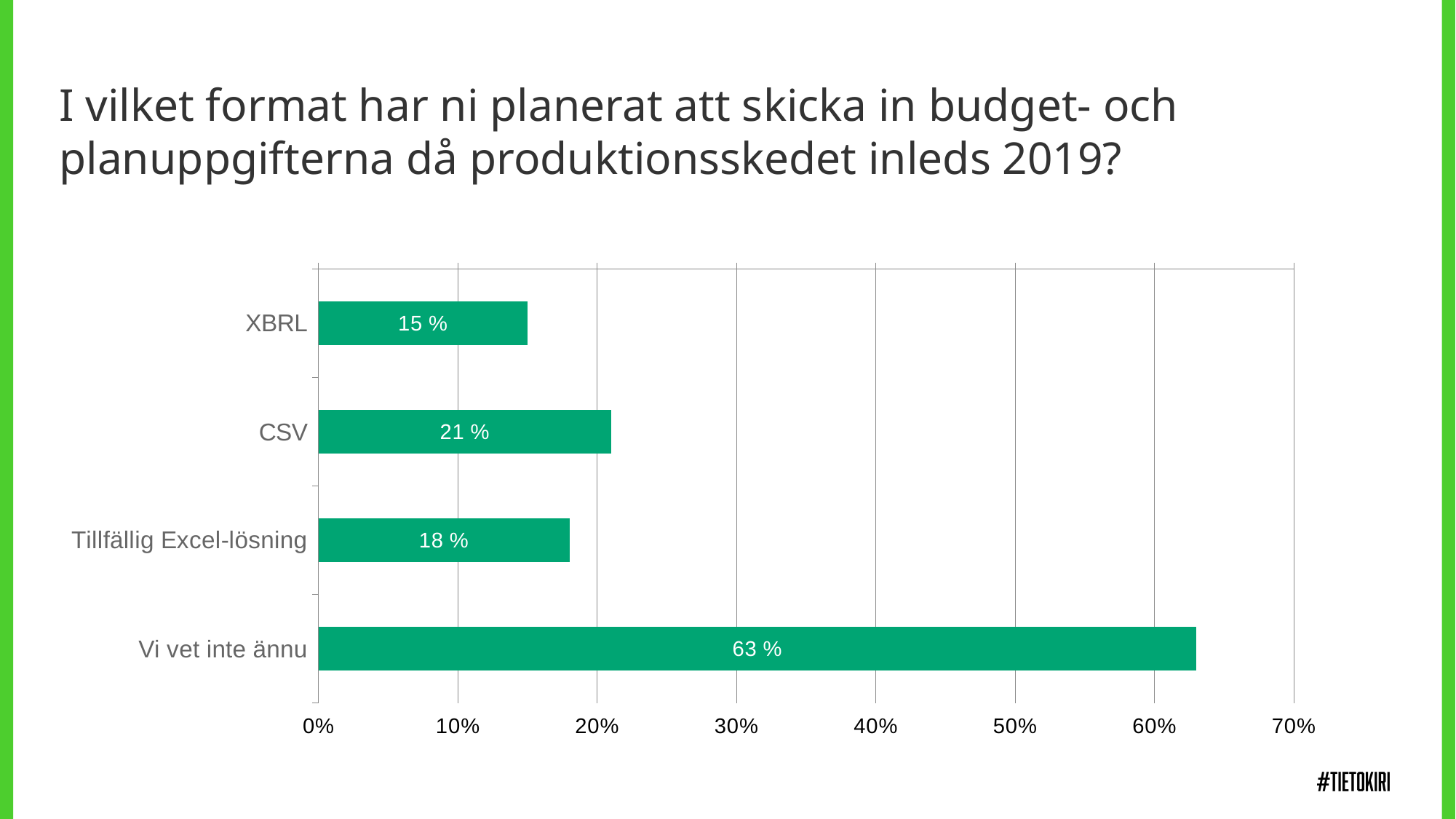
What is the value for Tillfällig Excel-lösning? 18 % Which category has the highest value? Vi vet inte ännu What is the value for XBRL? 15 % What is the value for CSV? 21 % What is the value for Vi vet inte ännu? 63 % Which is larger, the value for CSV or the value for Tillfällig Excel-lösning? CSV What is the difference between the values for CSV and XBRL? 6 % What kind of chart is shown on the slide? Bar chart What is the difference between the values for Vi vet inte ännu and CSV? 42 % Which category has the lowest value? XBRL Is the value for Vi vet inte ännu greater or less than 60%? greater How many categories are shown in the chart? 4